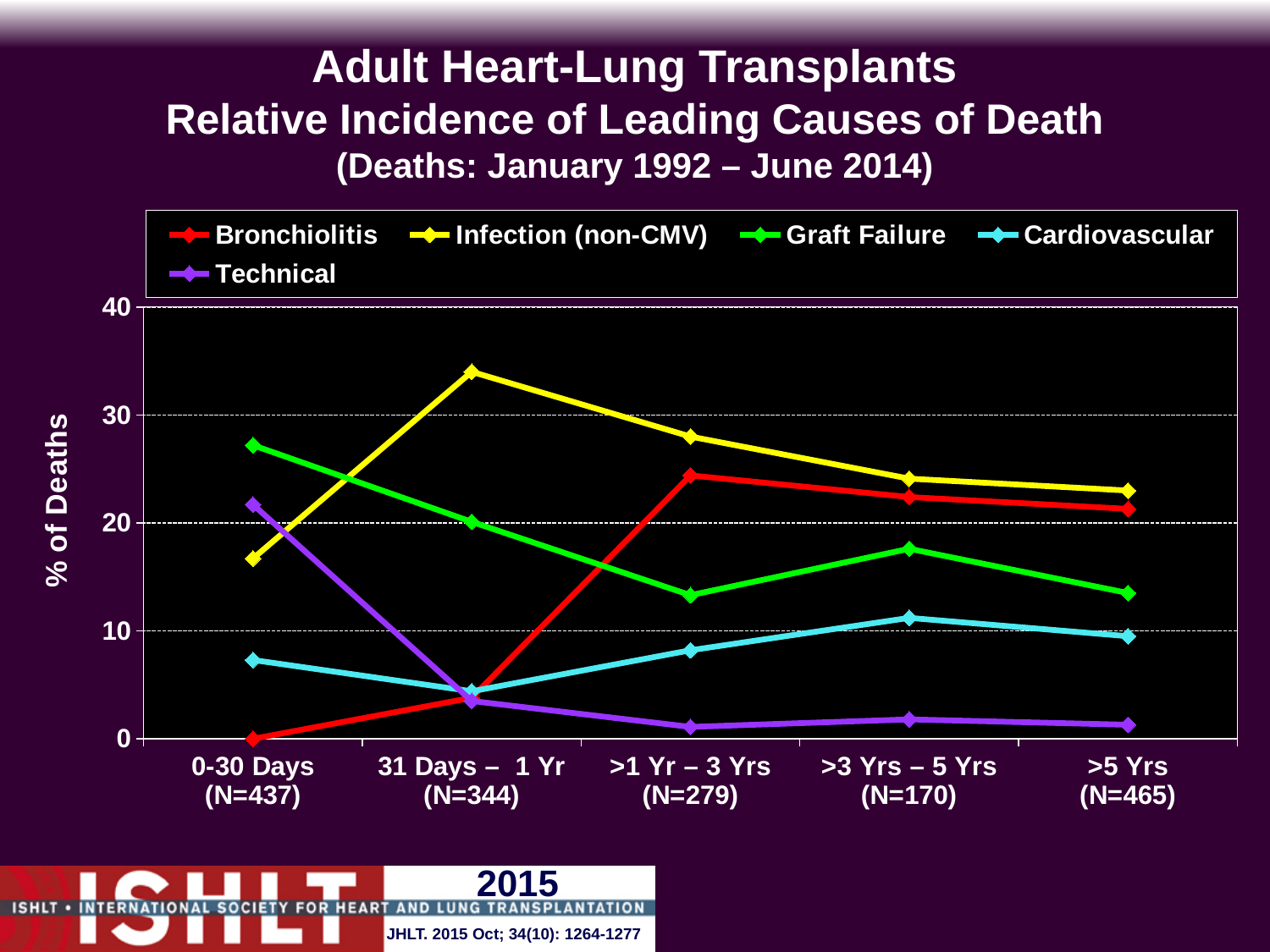
What type of chart is shown on the slide? Line chart Which cause of death has the lowest value at >5 Yrs? Technical Which cause of death has the highest value at 31 Days – 1 Yr? Infection (non-CMV) What is the label on the y axis? % of Deaths Is the value for Cardiovascular at 0-30 Days greater or less than 10? less Which cause of death has the highest value at 0-30 Days? Graft Failure Which is larger at >1 Yr – 3 Yrs, Graft Failure or Cardiovascular? Graft Failure Does the Technical line rise or fall from 0-30 Days to 31 Days – 1 Yr? Fall What is the value for Bronchiolitis at 0-30 Days? 0 Is the value for Infection (non-CMV) at 31 Days – 1 Yr greater or less than 30? greater How many time-period categories are shown on the x axis? 5 How many series does the legend list? 5